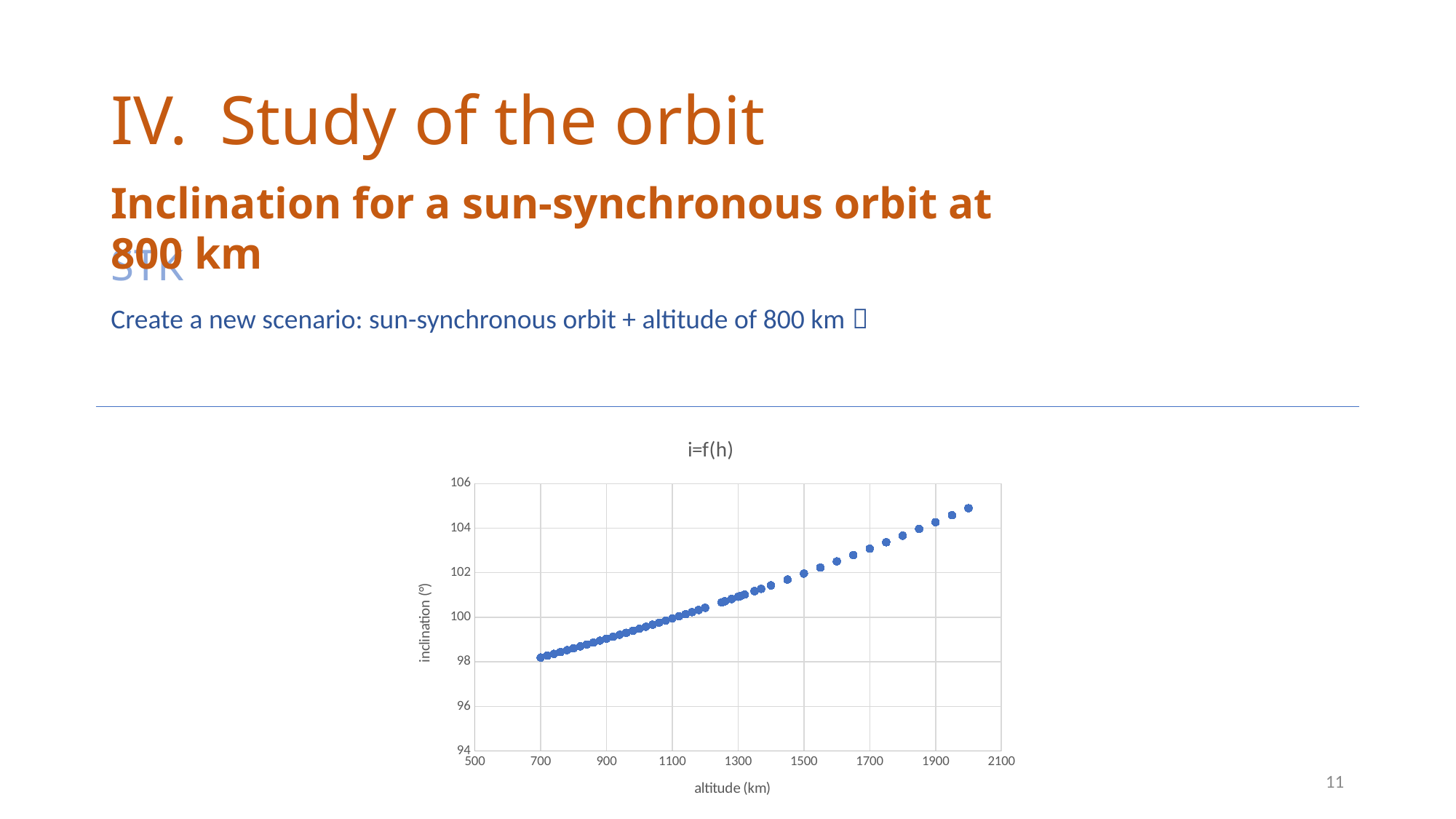
Does the inclination rise or fall as altitude increases along the x axis? rise Is the inclination at an altitude of 700 km greater or less than 100? less Is the inclination at an altitude of 900 km greater or less than 100? less What is the label of the x axis of the chart? altitude (km) Is the inclination at an altitude of 1300 km greater or less than 100? greater Which altitude has the higher inclination, 700 km or 2000 km? 2000 km What is the title of the chart? i=f(h) What kind of chart is shown on the slide? scatter chart At which altitude is the inclination highest? 2000 km At which altitude is the inclination lowest? 700 km